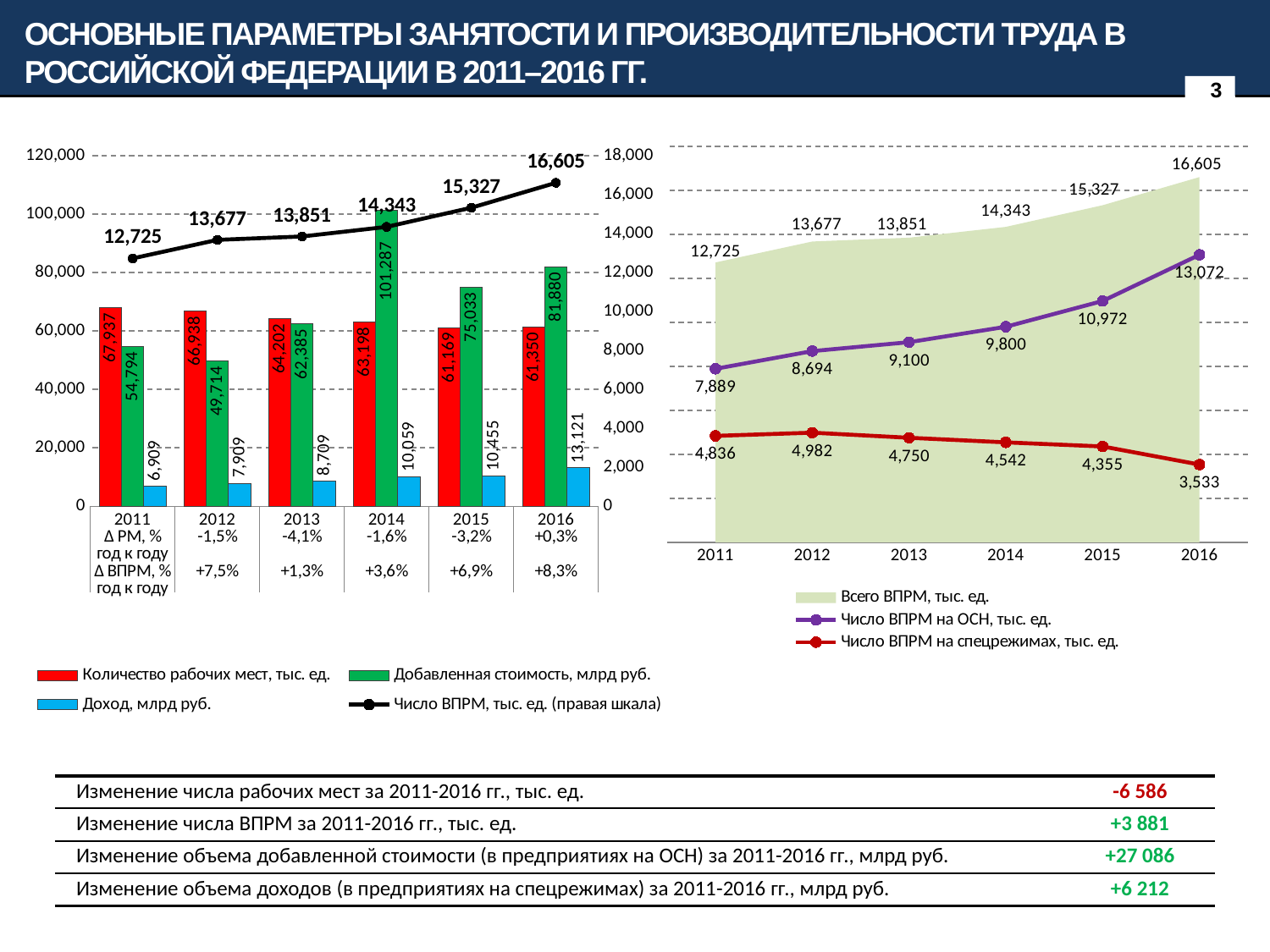
In the right chart, what is the value of Число ВПРМ на спецрежимах, тыс. ед. for 2016? 3,533 In the left chart, which year has the lowest value of Доход, млрд руб.? 2011 In the right chart, how many years are shown on the x axis? 6 In the right chart, does Число ВПРМ на спецрежимах rise or fall from 2012 to 2016? fall In the left chart, what is the value of Доход, млрд руб. for 2016? 13,121 In the left chart, what is the difference between Количество рабочих мест in 2011 and in 2016? 6,587 In the left chart, what is the value of Количество рабочих мест, тыс. ед. for 2011? 67,937 In the left chart, what is the value of Добавленная стоимость, млрд руб. for 2014? 101,287 In the right chart, what is the value of Число ВПРМ на ОСН, тыс. ед. for 2015? 10,972 In the left chart, how many series does the legend list? 4 In the right chart, which is larger in 2013: Число ВПРМ на ОСН or Число ВПРМ на спецрежимах? Число ВПРМ на ОСН In the left chart, which year has the highest value of Добавленная стоимость, млрд руб.? 2014